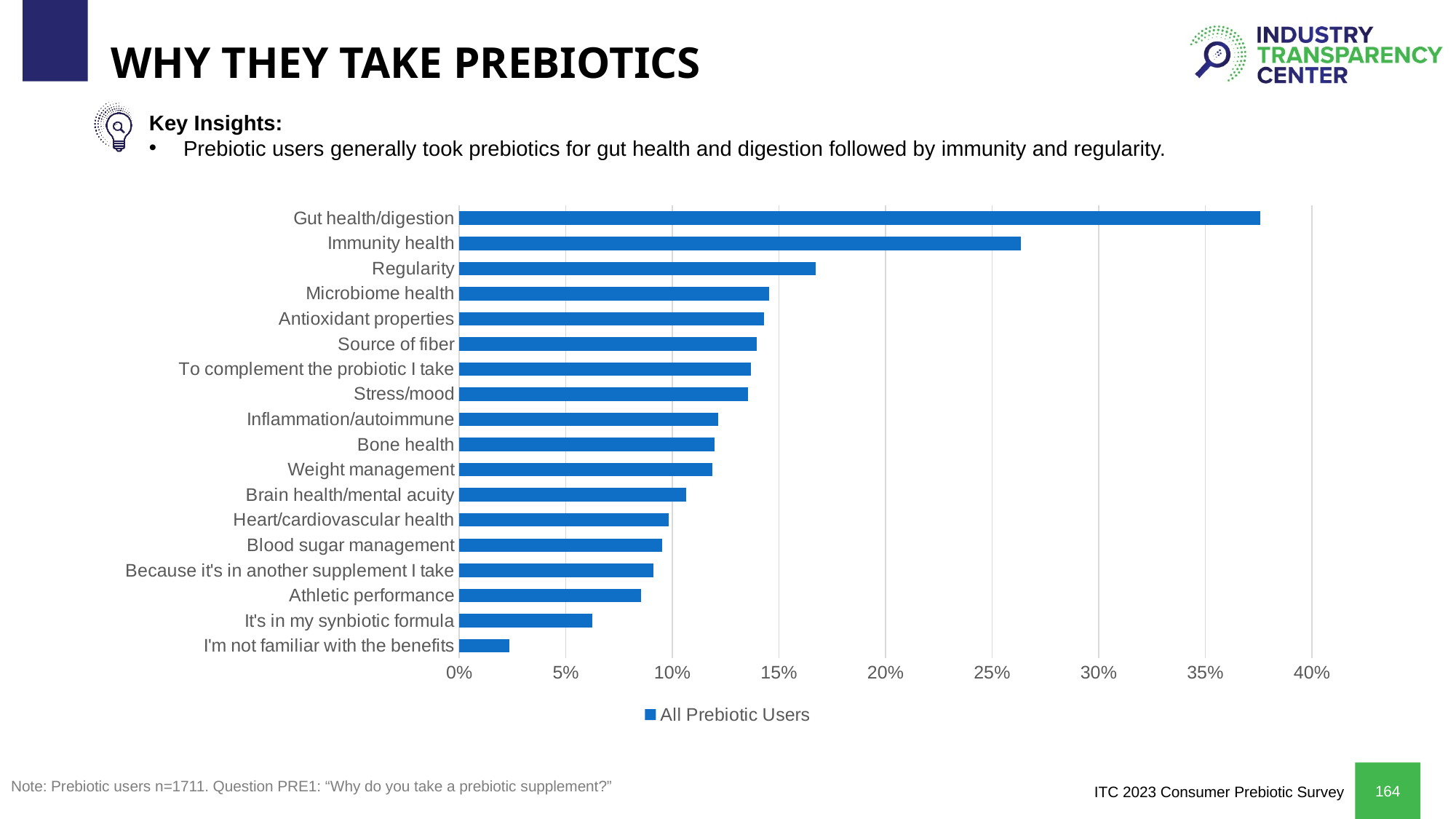
Is the value for Gut health/digestion greater or less than 35%? greater Is the value for Regularity greater or less than 15%? greater How many categories (reasons) are plotted in the chart? 18 Is the value for I'm not familiar with the benefits greater or less than 5%? less How many series does the legend list? 1 What kind of chart is shown on the slide? Bar chart What series name is shown in the chart legend? All Prebiotic Users Which reason has the lowest value in the chart? I'm not familiar with the benefits Which is larger, the value for Immunity health or the value for Regularity? Immunity health Which reason has the highest value in the chart? Gut health/digestion